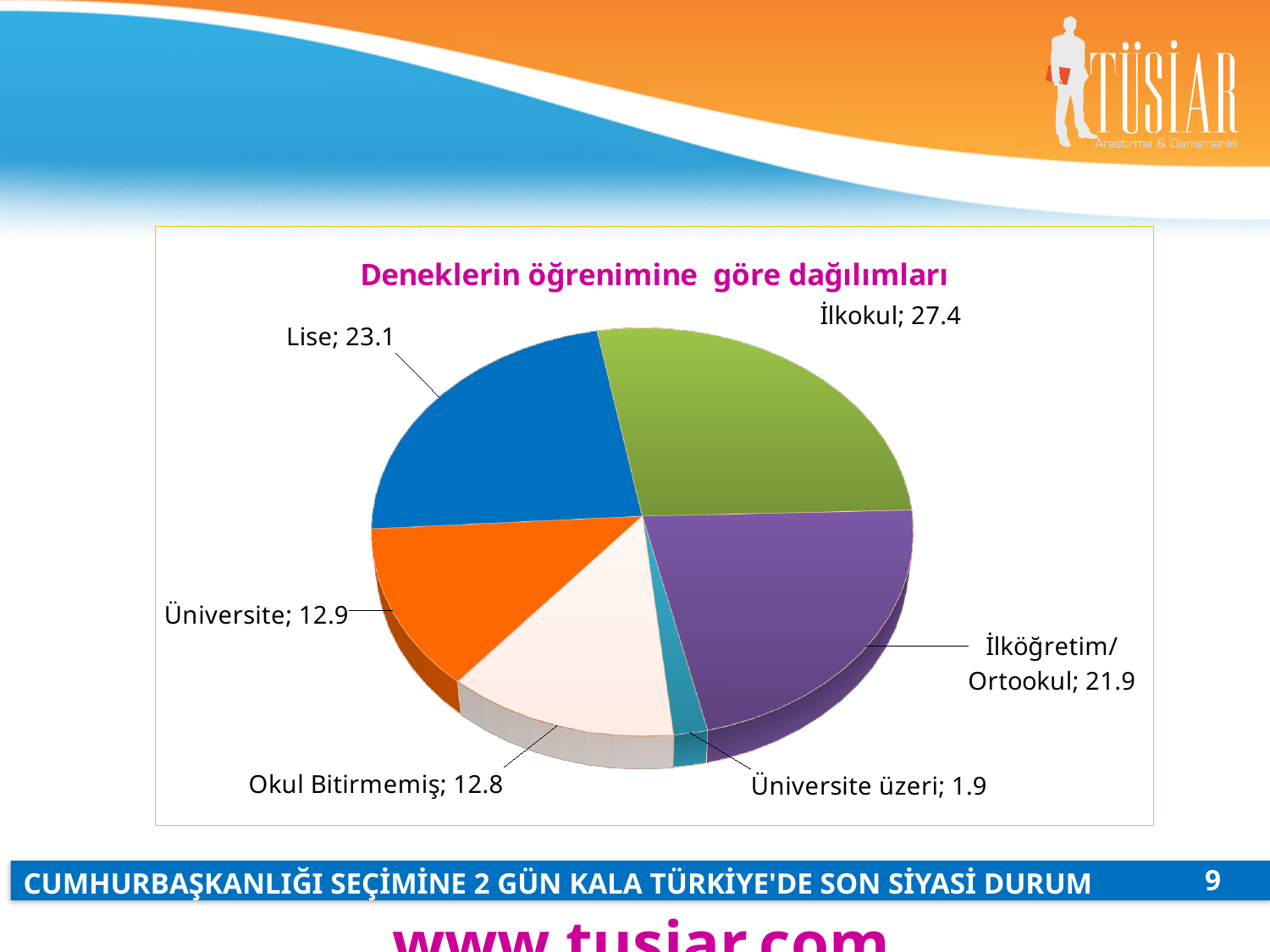
What is the value for İlköğretim/Ortookul? 21.9 What is the value for Üniversite üzeri? 1.9 What type of chart is shown on the slide? Pie chart What is the difference between the values for İlkokul and Lise? 4.3 Which category has the smallest slice of the pie? Üniversite üzeri Which is larger, the value for Lise or the value for İlköğretim/Ortookul? Lise What is the title of the chart? Deneklerin öğrenimine göre dağılımları How many categories are shown in the pie chart? 6 What is the value for İlkokul? 27.4 Which category has the largest slice of the pie? İlkokul What is the value for Lise? 23.1 What is the value for Okul Bitirmemiş? 12.8